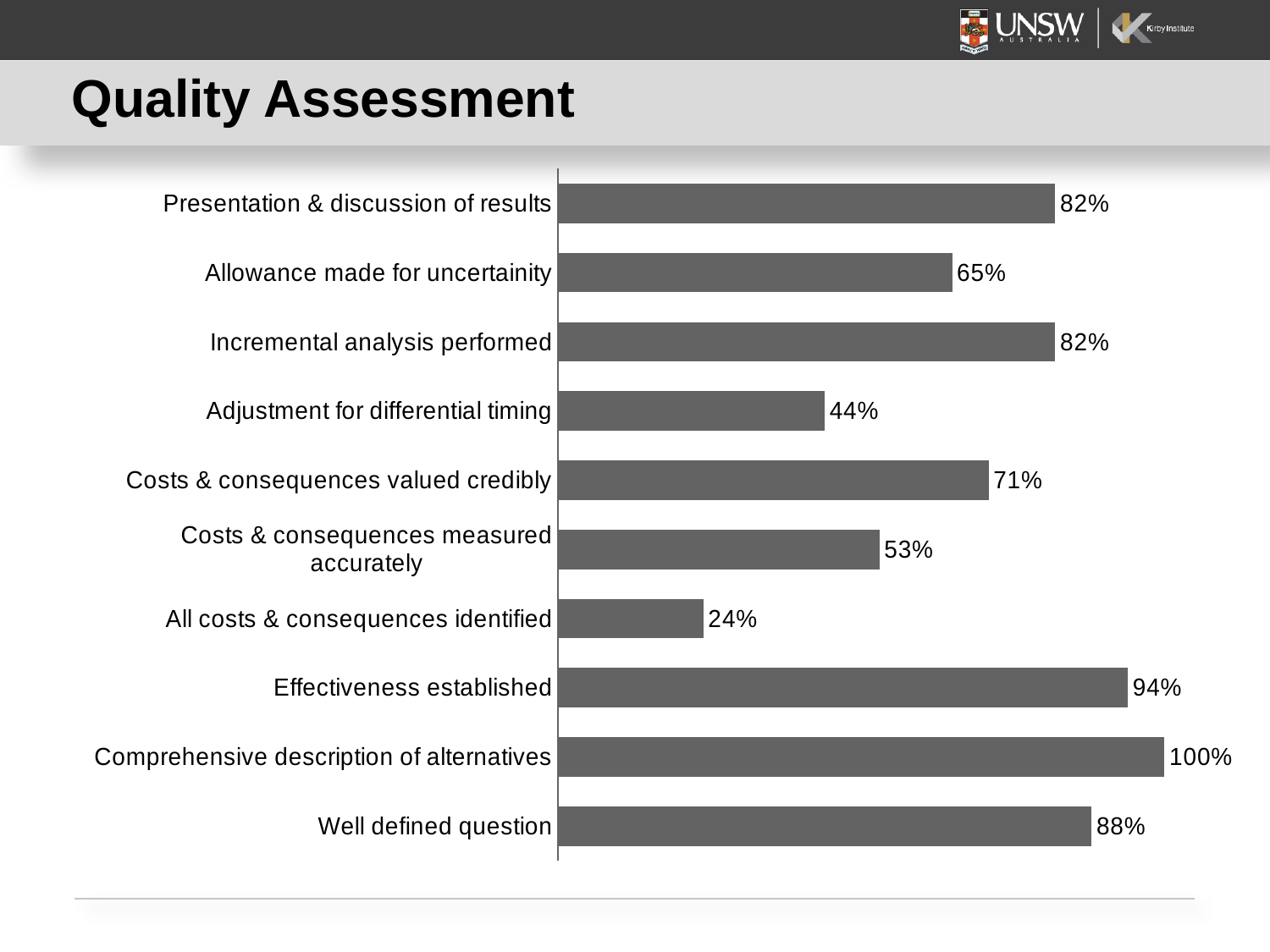
Which category has the highest value? Comprehensive description of alternatives What is the difference between the values for Presentation & discussion of results and All costs & consequences identified? 58% Which category has the lowest value? All costs & consequences identified What kind of chart is shown on the slide? Bar chart Which is larger, the value for Well defined question or the value for Incremental analysis performed? Well defined question What is the difference between the values for Effectiveness established and Costs & consequences valued credibly? 23% What is the value for Costs & consequences measured accurately? 53% How many categories are shown in the chart? 10 What is the value for Well defined question? 88% What is the value for Allowance made for uncertainity? 65% What is the value for Adjustment for differential timing? 44% What is the title of the slide containing the chart? Quality Assessment